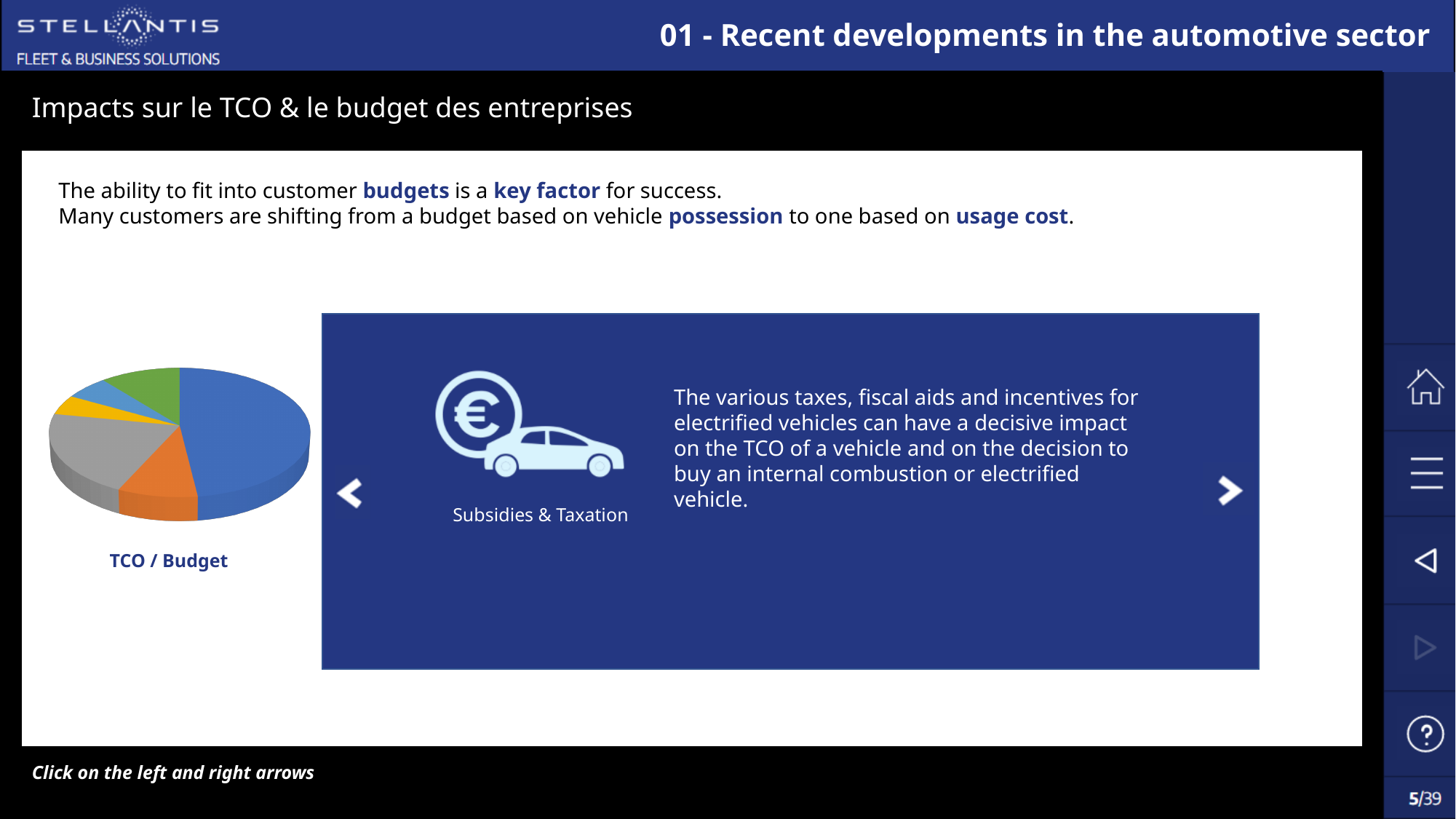
What kind of chart is shown under the label "TCO / Budget"? Pie chart How many slices does the TCO / Budget pie chart have? 6 In the TCO / Budget pie chart, which is larger, the gray slice or the yellow slice? Gray What is the label shown beneath the pie chart? TCO / Budget Does the TCO / Budget pie chart display a legend? No Which colour slice is the smallest in the TCO / Budget pie chart? Yellow In the TCO / Budget pie chart, which is larger, the blue slice or the green slice? Blue Which colour slice is the largest in the TCO / Budget pie chart? Blue